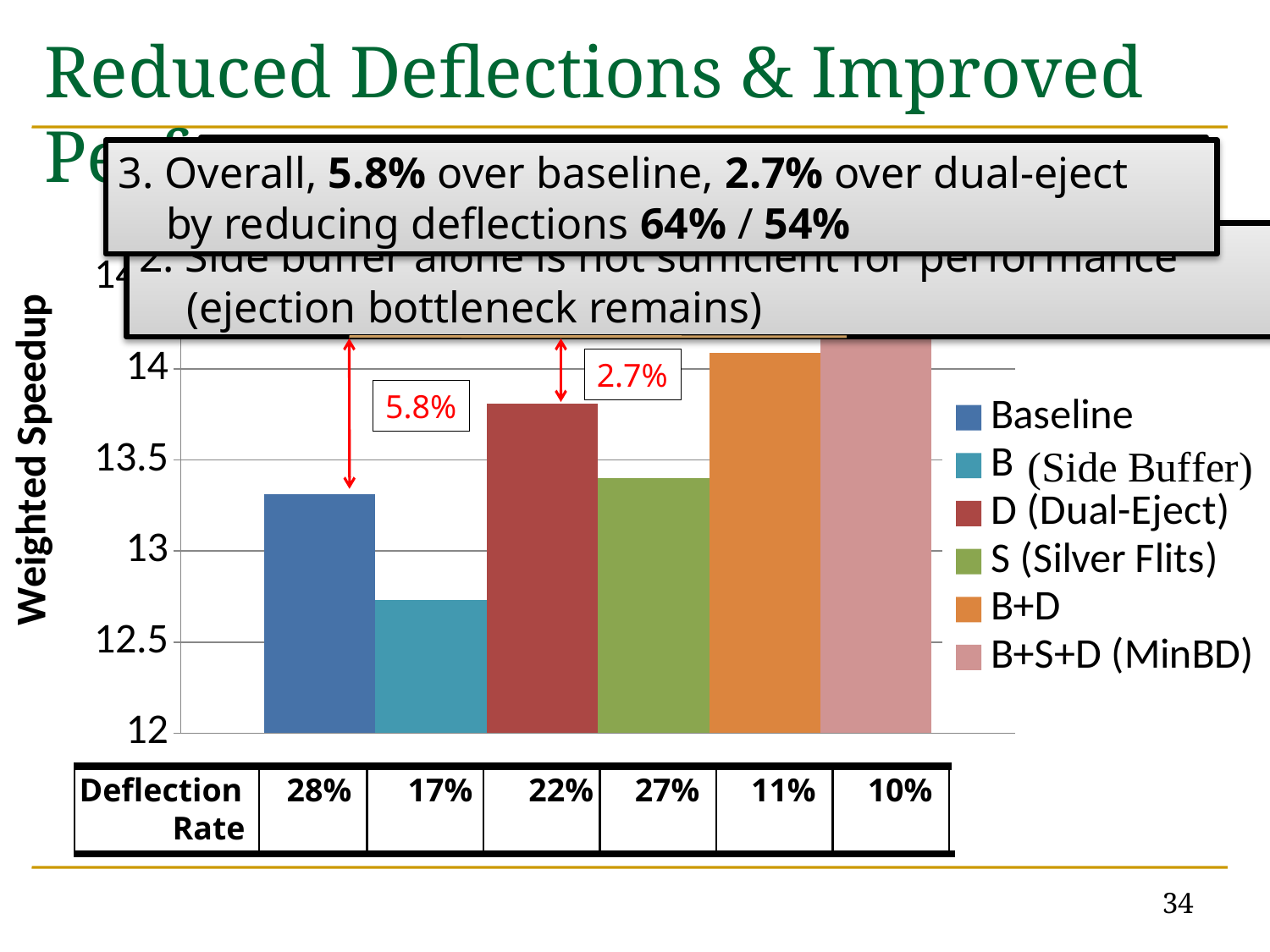
How many entries does the chart legend list? 6 Which has a higher weighted speedup, D (Dual-Eject) or S (Silver Flits)? D (Dual-Eject) Is the weighted speedup for B (Side Buffer) greater or less than 13? less What kind of chart is shown on the slide? bar chart What is the deflection rate shown for the Baseline bar in the table below the chart? 28% What is the label on the vertical axis of the chart? Weighted Speedup Is the weighted speedup for B+D greater or less than 14? greater How many bars are plotted in the chart? 6 Which configuration has the highest weighted speedup? B+S+D (MinBD) Which configuration has the lowest weighted speedup? B (Side Buffer) Is the weighted speedup for D (Dual-Eject) greater or less than 13.5? greater